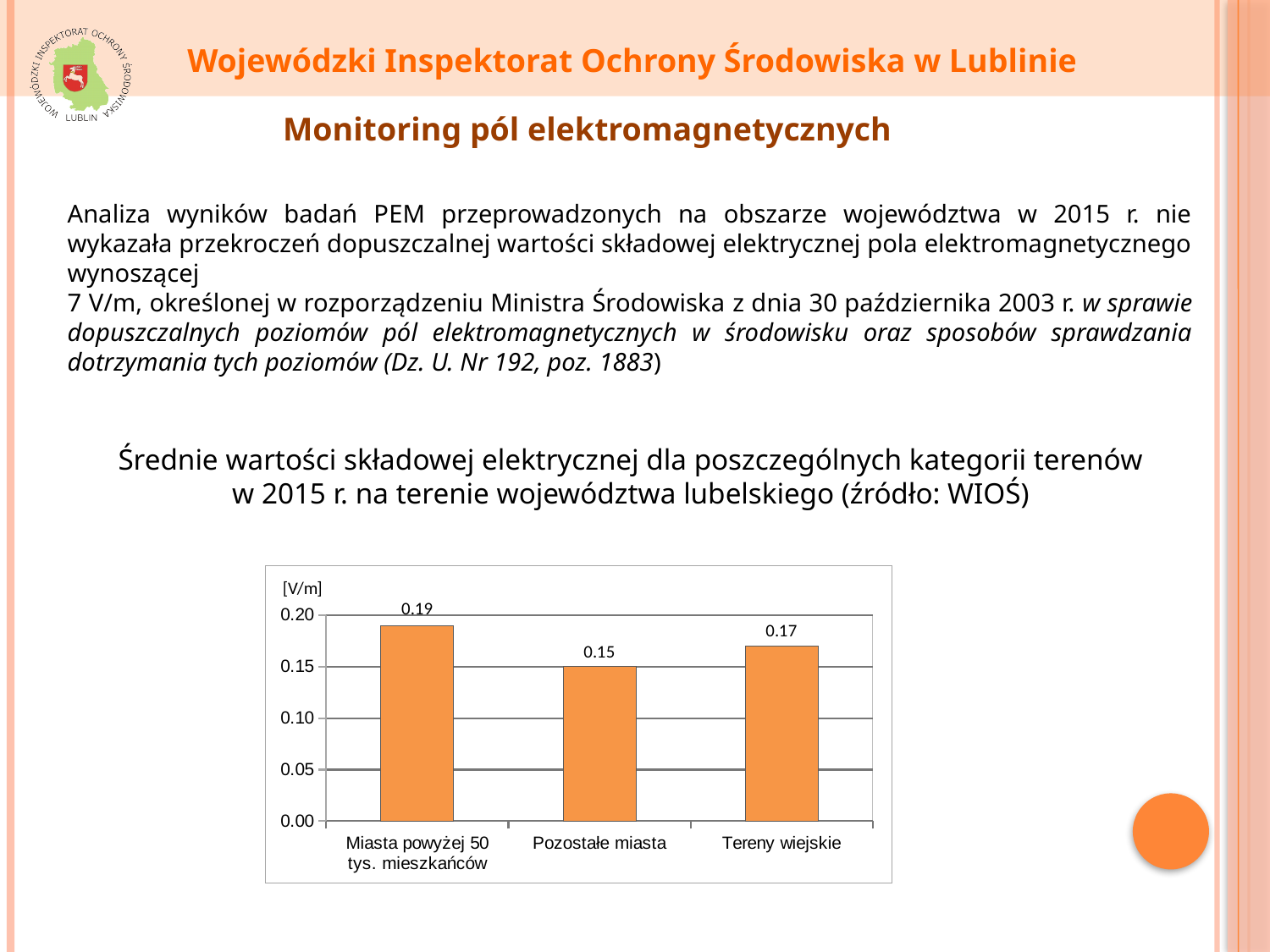
What is the value for Miasta powyżej 50 tys. mieszkańców? 0.19 How many categories are shown on the chart? 3 Which category has the highest value? Miasta powyżej 50 tys. mieszkańców Which category has the lowest value? Pozostałe miasta What is the value for Tereny wiejskie? 0.17 What is the difference between the values for Miasta powyżej 50 tys. mieszkańców and Pozostałe miasta? 0.04 Is the value for Tereny wiejskie greater or less than 0.20? less Which is larger, the value for Tereny wiejskie or the value for Pozostałe miasta? Tereny wiejskie What kind of chart is shown on the slide? bar chart What unit is shown on the vertical axis of the chart? [V/m] What is the value for Pozostałe miasta? 0.15 What is the difference between the values for Tereny wiejskie and Pozostałe miasta? 0.02